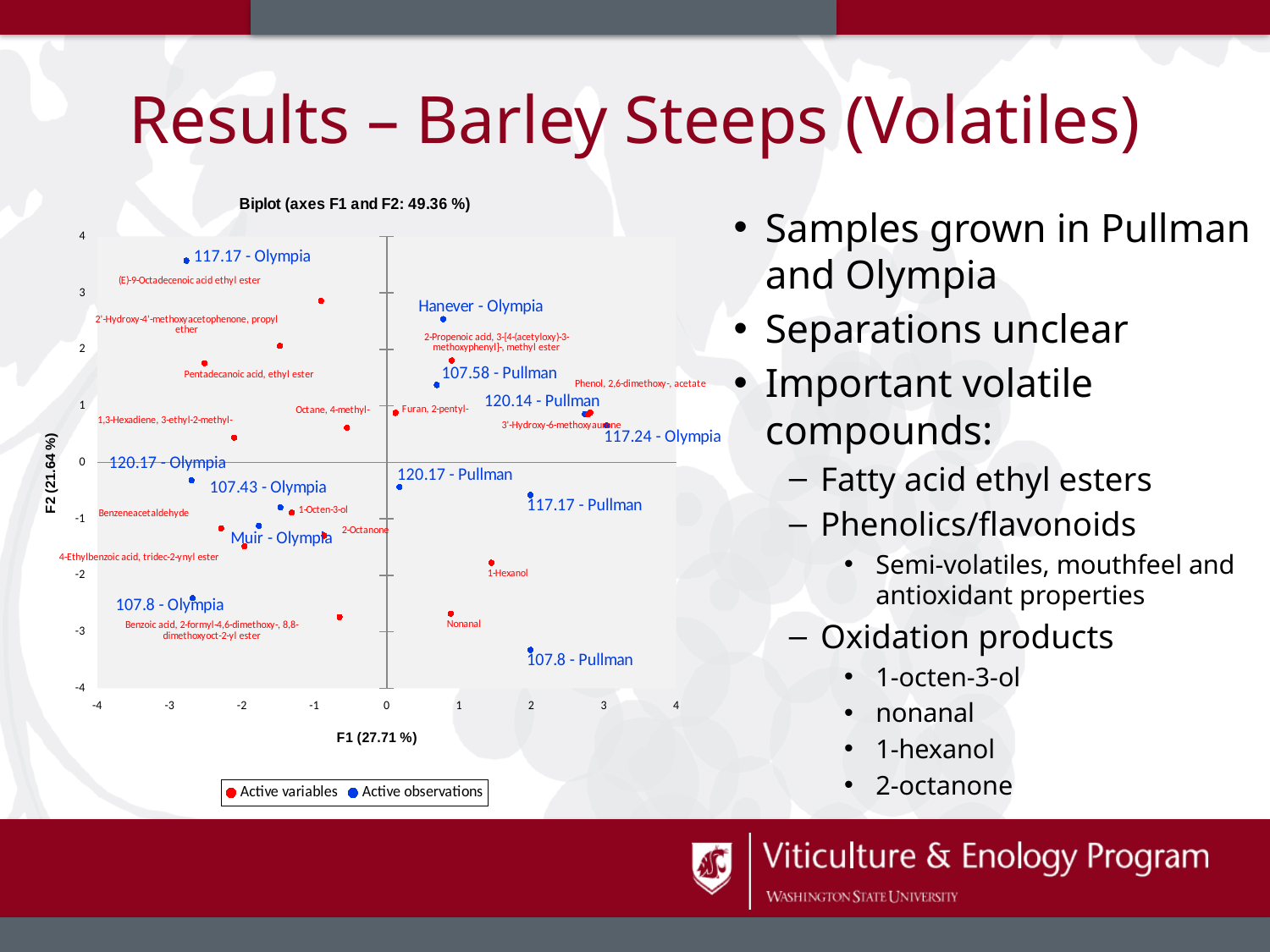
Which active observation has the highest F2 value on the biplot? 117.17 - Olympia Is the F1 value for the observation 117.24 - Olympia greater or less than 2? greater Which active observation has the lowest F2 value on the biplot? 107.8 - Pullman What is the title of the chart? Biplot (axes F1 and F2: 49.36 %) Which observation has the higher F2 value, 117.17 - Olympia or 107.8 - Olympia? 117.17 - Olympia Is the F2 value for the observation 117.17 - Olympia greater or less than 3? greater Is the F2 value for the observation Hanever - Olympia greater or less than 2? greater How many series does the chart legend list? 2 What is the label of the horizontal axis of the biplot? F1 (27.71 %) What kind of chart is shown on the slide? scatter chart (biplot)